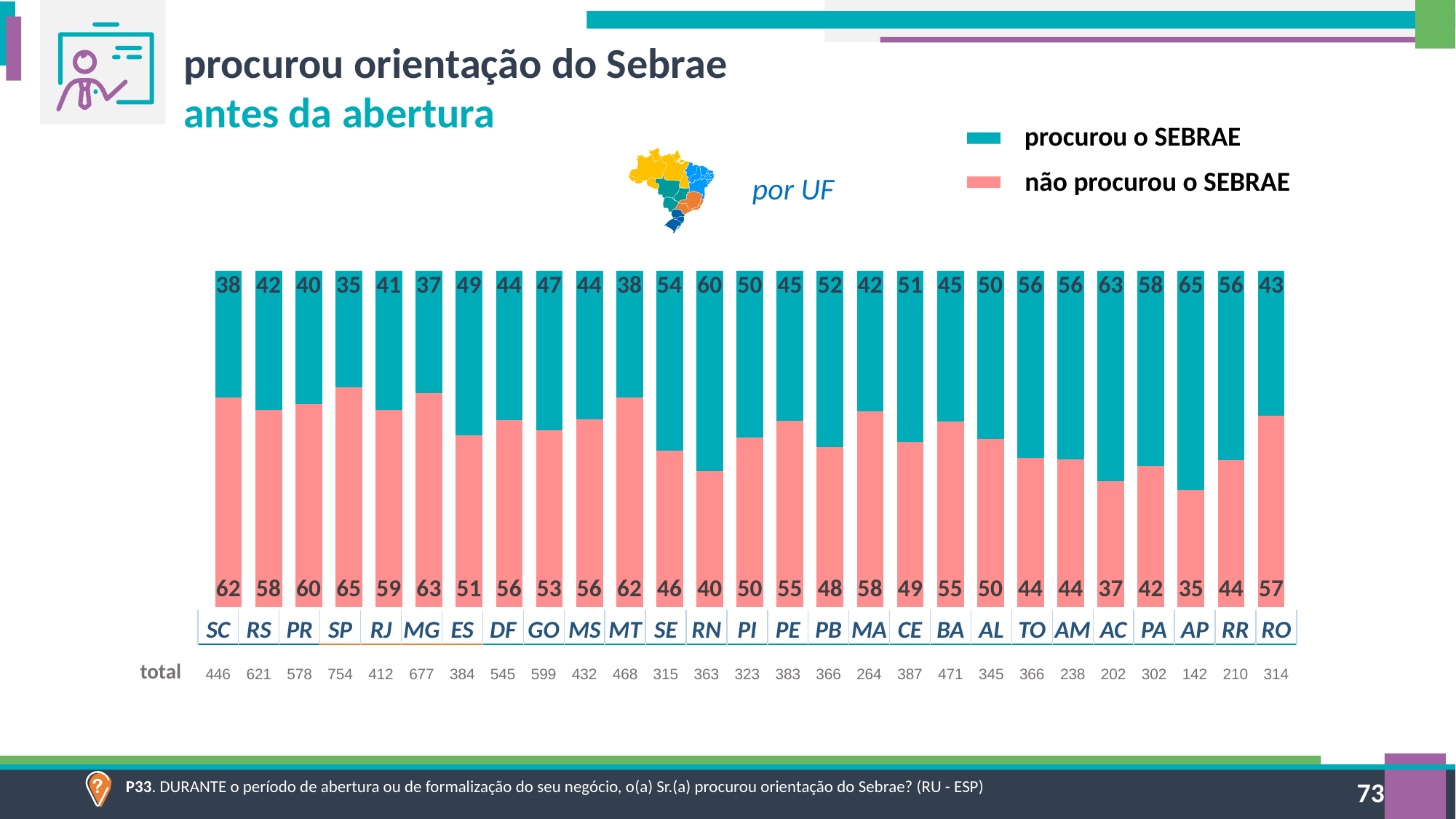
What is the value for não procurou o SEBRAE in RN? 40 How many series does the legend list? 2 Which UF has the lowest value for procurou o SEBRAE? SP What is the total number of respondents shown for SP in the 'total' row? 754 Which UF has the highest value for procurou o SEBRAE? AP Which has a larger procurou o SEBRAE value, ES or DF? ES How many UFs are shown on the x axis of the chart? 27 What is the difference between the procurou o SEBRAE values for AC and SC? 25 What percentage of respondents in SP procurou o SEBRAE? 35 What kind of chart is shown on the slide? Stacked bar chart Which colour represents 'não procurou o SEBRAE' in the chart? Pink (salmon) What is the sum of the procurou and não procurou values for the MT bar? 100